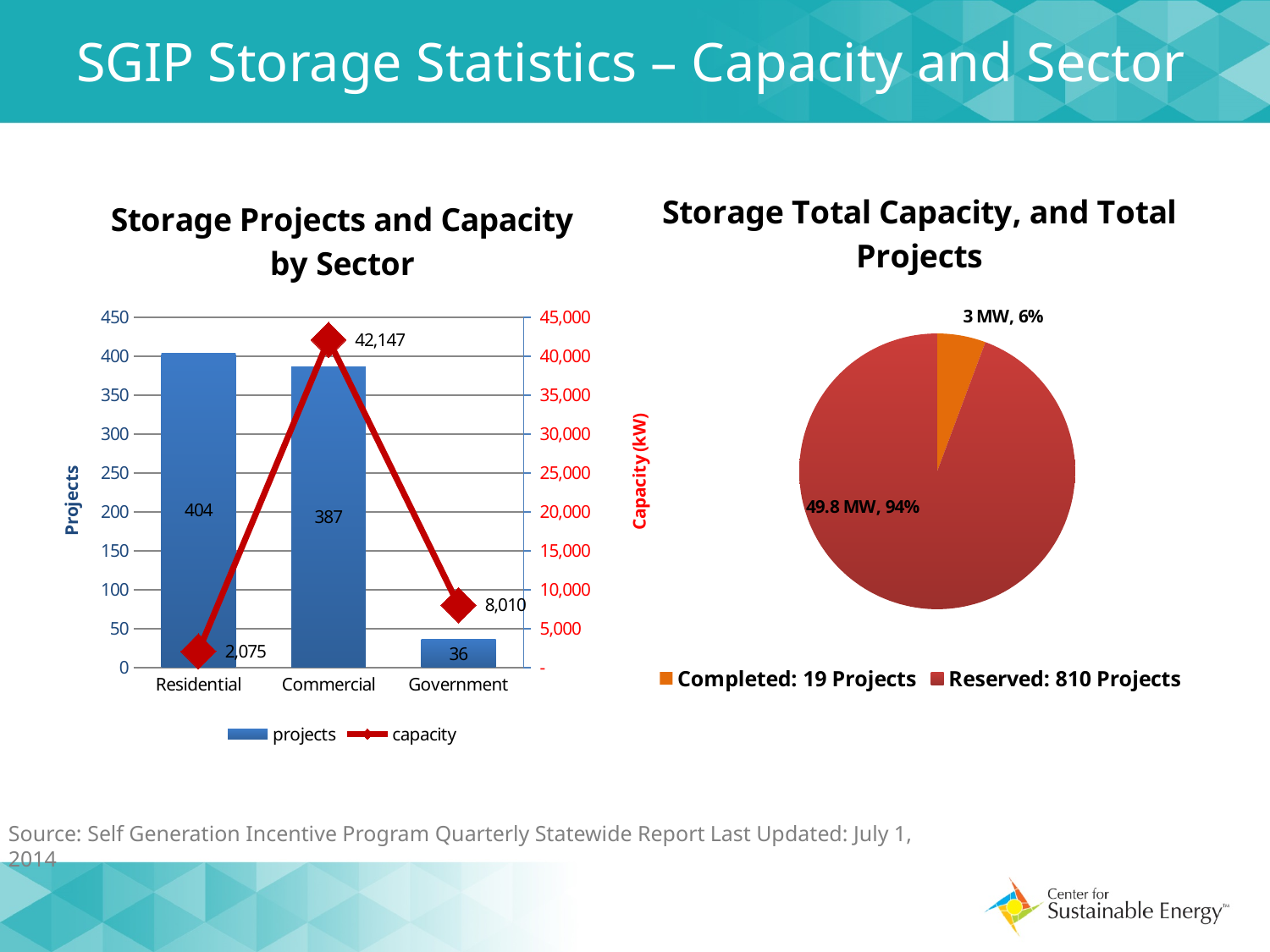
In the 'Storage Projects and Capacity by Sector' chart, what is the difference in capacity between Commercial and Government? 34,137 In the 'Storage Total Capacity, and Total Projects' chart, what is the capacity value for Reserved? 49.8 MW In the 'Storage Projects and Capacity by Sector' chart, how many sectors are shown on the x axis? 3 What kind of chart is 'Storage Total Capacity, and Total Projects'? Pie chart In the 'Storage Projects and Capacity by Sector' chart, how many series does the legend list? 2 In the 'Storage Projects and Capacity by Sector' chart, how many projects are in the Residential sector? 404 In the 'Storage Projects and Capacity by Sector' chart, what is the capacity for the Commercial sector? 42,147 In the 'Storage Projects and Capacity by Sector' chart, which sector has the highest capacity? Commercial In the 'Storage Total Capacity, and Total Projects' chart, what share of the pie is Completed? 6% In the 'Storage Projects and Capacity by Sector' chart, which sector has the lowest number of projects? Government In the 'Storage Projects and Capacity by Sector' chart, which has the larger capacity, Residential or Government? Government In the 'Storage Projects and Capacity by Sector' chart, what is the difference in projects between Residential and Commercial? 17